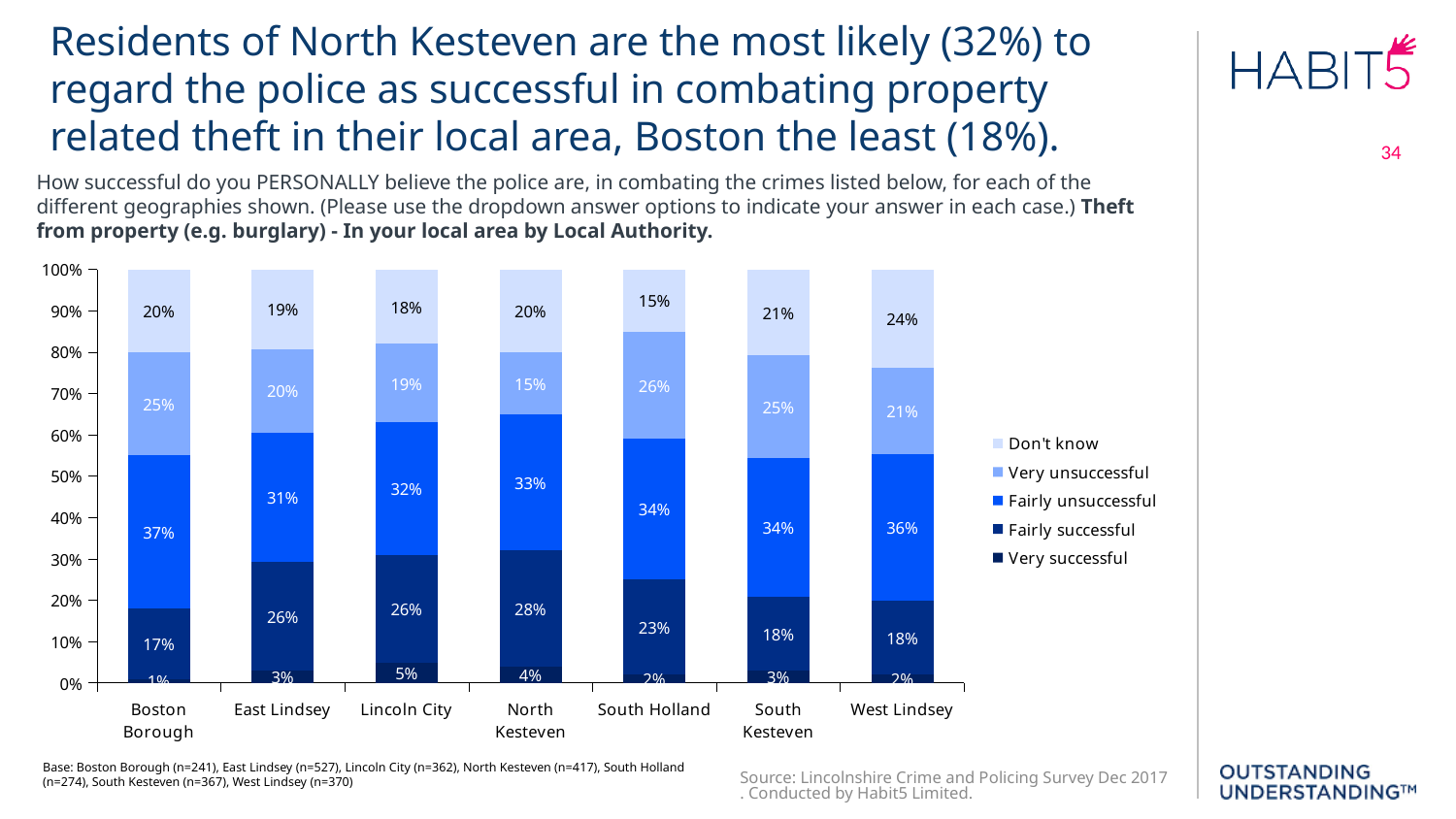
What percentage of Boston Borough residents answered 'Fairly unsuccessful'? 37% What is the 'Don't know' value for South Holland? 15% Which local authority has the highest 'Very successful' percentage? Lincoln City Which has a larger 'Fairly successful' value, North Kesteven or South Holland? North Kesteven How many local authorities are shown on the x axis? 7 What is the difference in percentage points between the 'Don't know' values for West Lindsey and South Holland? 9 percentage points How many series does the legend list? 5 What kind of chart is shown on the slide? Stacked bar chart Which local authority has the highest 'Don't know' percentage? West Lindsey What percentage of North Kesteven residents answered 'Fairly successful'? 28% Which local authority has the lowest 'Very unsuccessful' percentage? North Kesteven What is the 'Very unsuccessful' value for West Lindsey? 21%